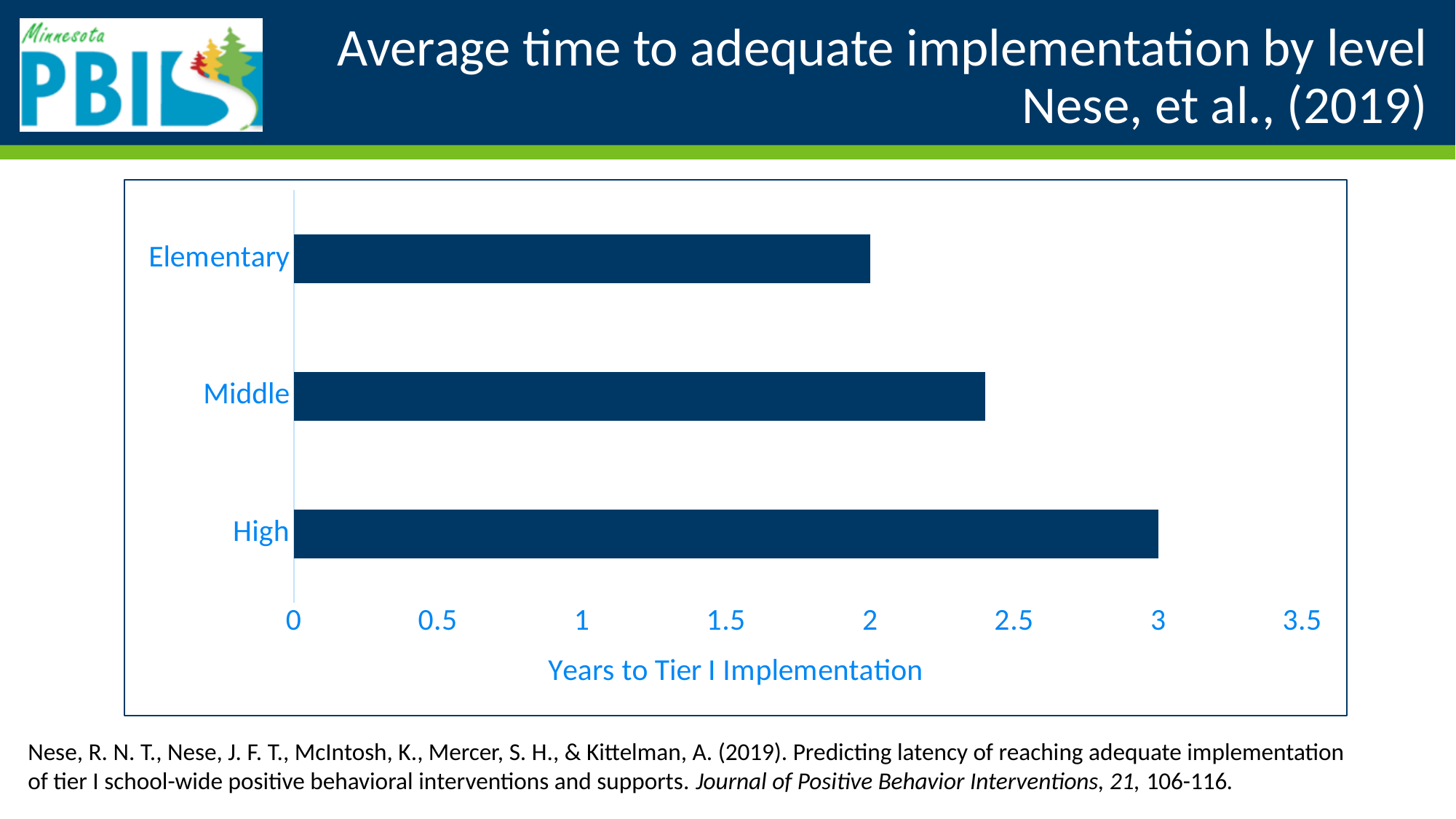
How many school levels are plotted in the chart? 3 What is the label of the horizontal axis? Years to Tier I Implementation Which has a larger value, Middle or High? High Is the value for Middle greater or less than 2.5? less What is the highest value shown on the horizontal axis? 3.5 How many years to Tier I implementation are shown for High? 3 Which school level has the shortest average time to Tier I implementation? Elementary What kind of chart is shown on the slide? bar chart Which school level has the longest average time to Tier I implementation? High How many years to Tier I implementation are shown for Elementary? 2 What is the difference in years between High and Elementary? 1 Is the value for Middle greater or less than 2? greater